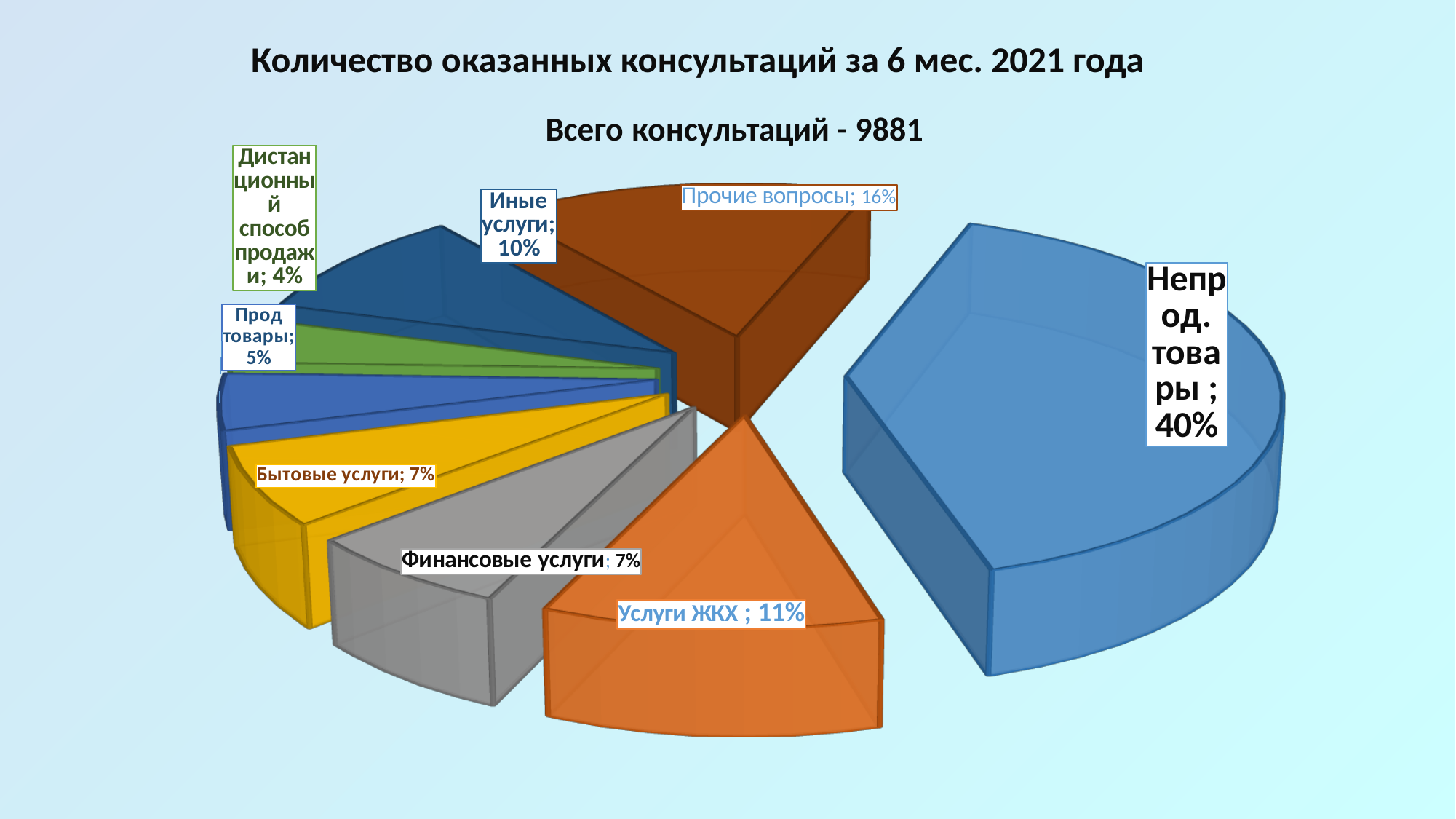
What share of the pie does "Прочие вопросы" have? 16% What is the difference in percentage points between "Непрод. товары" and "Прочие вопросы"? 24 Which category has the smallest share of the pie? Дистанционный способ продажи What share of the pie does "Непрод. товары" have? 40% How many slices does the pie chart have? 8 Which is larger, the share for "Услуги ЖКХ" or the share for "Иные услуги"? Услуги ЖКХ What is the value shown for "Прод товары"? 5% What is the value shown for "Услуги ЖКХ"? 11% What is the value shown for "Дистанционный способ продажи"? 4% What is the value shown for "Иные услуги"? 10% Which category has the largest share of the pie? Непрод. товары What kind of chart is shown on the slide? pie chart